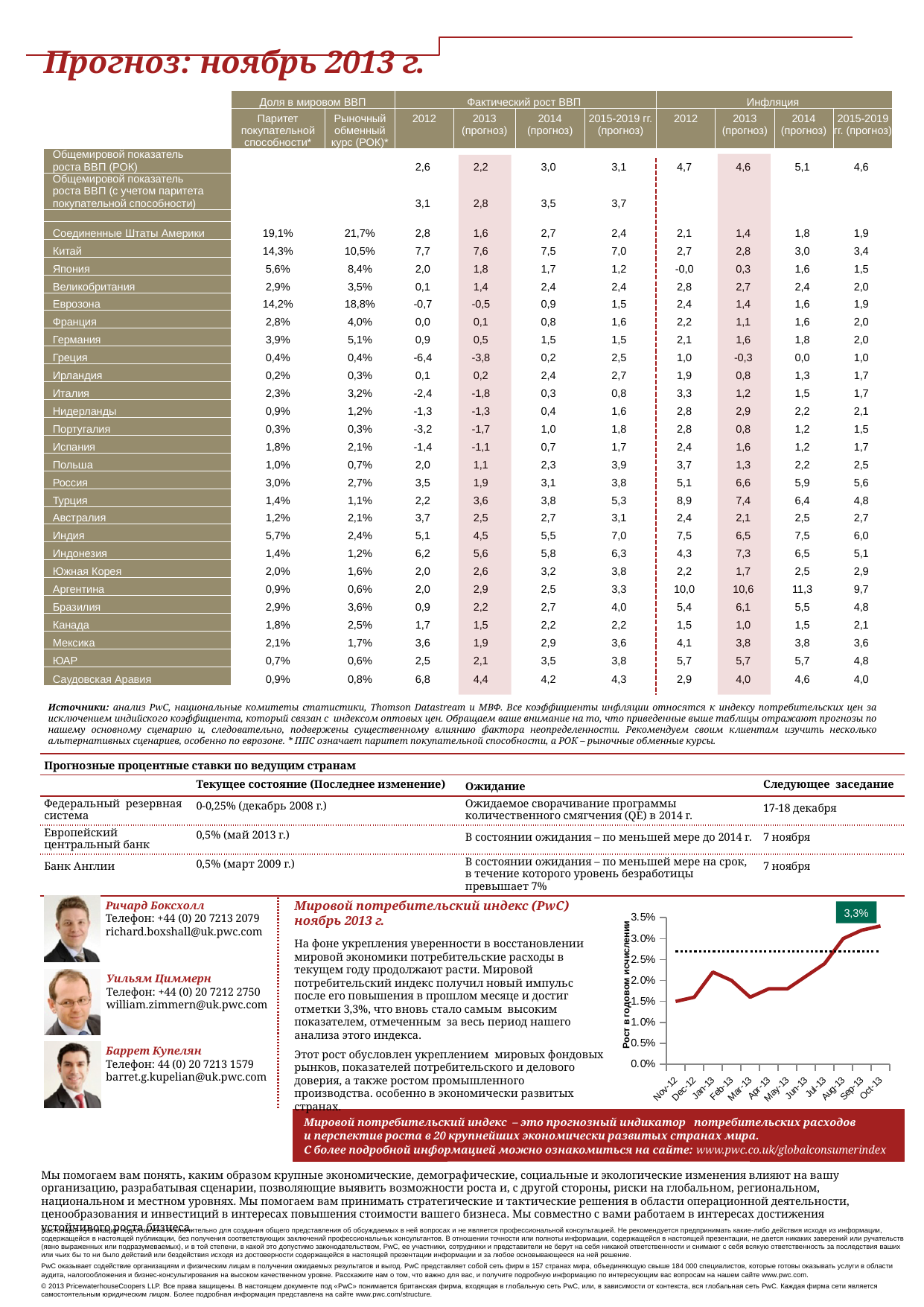
In the consumer index line chart, does the value rise or fall overall from Nov-12 to Oct-13? rise In the consumer index line chart, which month has the highest value? Oct-13 In the consumer index line chart, is the value for Aug-13 greater or less than 2.5%? greater In the consumer index line chart, which is larger, the value for Jul-13 or the value for Apr-13? Jul-13 In the consumer index line chart, is the value for Jan-13 greater or less than 2.0%? greater In the consumer index line chart, what value is labelled for Oct-13? 3,3% What is the y-axis label of the consumer index line chart? Рост в годовом исчислении In the consumer index line chart, is the value for Nov-12 greater or less than 2.0%? less In the consumer index line chart, how many monthly points are plotted on the x axis? 12 In the consumer index line chart, which is larger, the value for Jan-13 or the value for Mar-13? Jan-13 What kind of chart is the 'Мировой потребительский индекс (PwC) ноябрь 2013 г.' chart? line chart